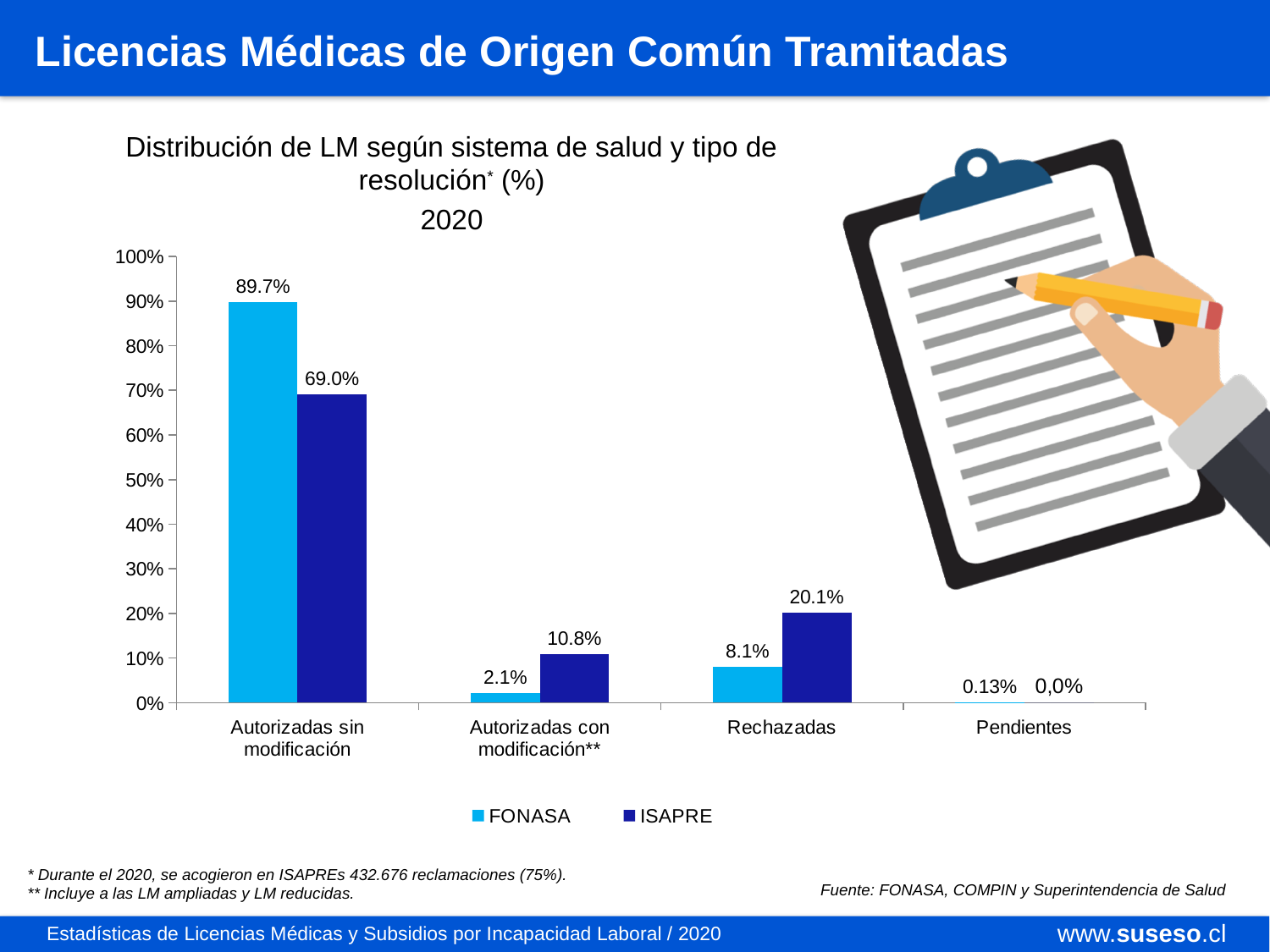
What is the FONASA value for Autorizadas sin modificación? 89.7% What is the ISAPRE value for Autorizadas sin modificación? 69.0% How many categories are shown on the x axis? 4 What kind of chart is shown on the slide? Bar chart What is the difference between the FONASA and ISAPRE values for Autorizadas sin modificación? 20.7% What is the ISAPRE value for Rechazadas? 20.1% Which year does the chart title refer to? 2020 For Rechazadas, which series has the larger value, FONASA or ISAPRE? ISAPRE Which category has the lowest ISAPRE value? Pendientes How many series does the legend list? 2 What is the FONASA value for Autorizadas con modificación**? 2.1% Which category has the highest FONASA value? Autorizadas sin modificación